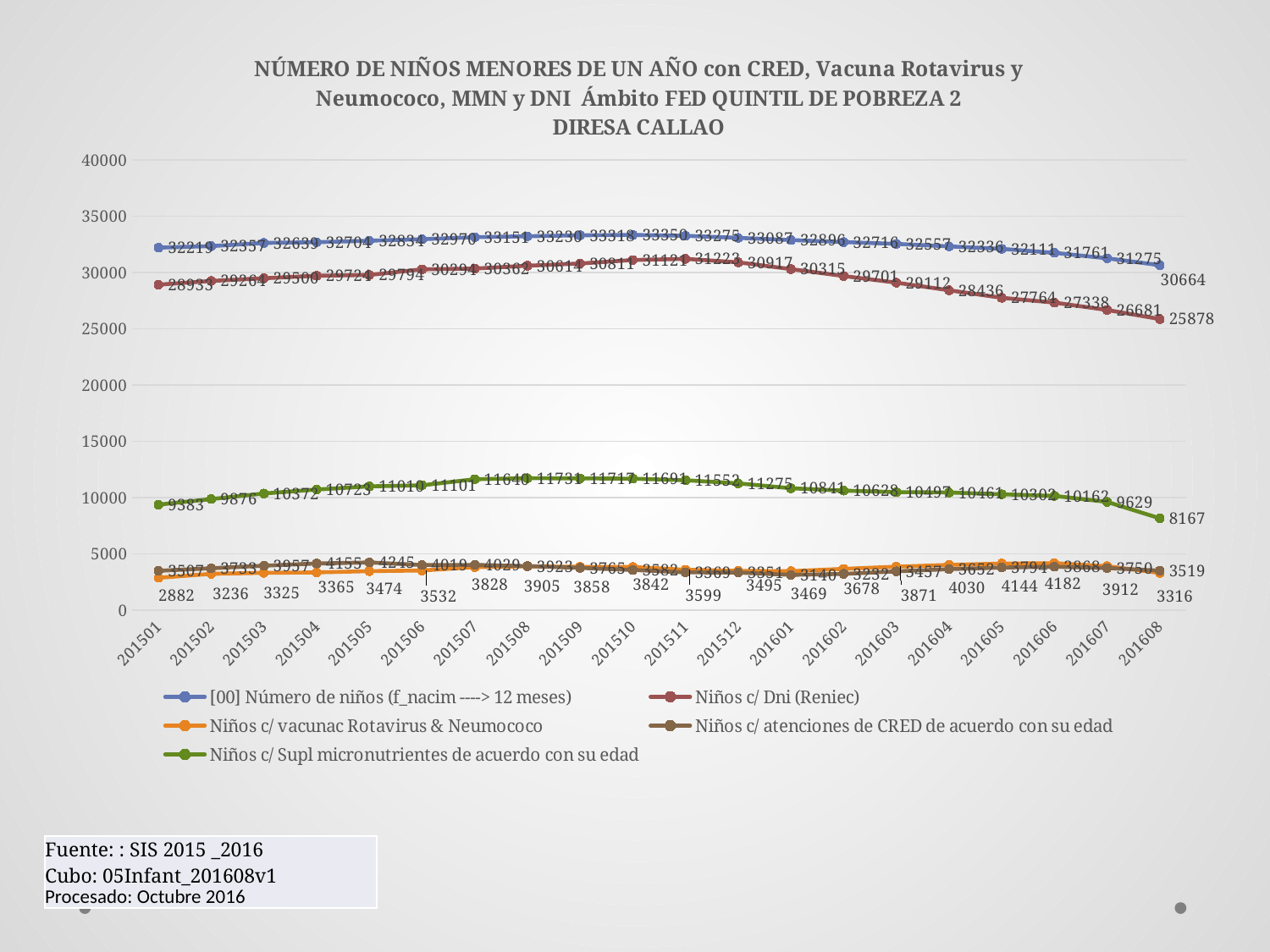
In which month does 'Niños c/ Supl micronutrientes de acuerdo con su edad' reach its highest value? 201508 What is the value of 'Niños c/ vacunac Rotavirus & Neumococo' at 201501? 2882 What is the value of 'Niños c/ Supl micronutrientes de acuerdo con su edad' at 201608? 8167 Is the value of '[00] Número de niños' at 201501 greater or less than 30000? greater How many months are shown on the x axis? 20 At 201608, which is larger: 'Niños c/ vacunac Rotavirus & Neumococo' or 'Niños c/ atenciones de CRED de acuerdo con su edad'? Niños c/ atenciones de CRED de acuerdo con su edad What is the value of the series '[00] Número de niños (f_nacim ----> 12 meses)' at 201608? 30664 What is the difference between '[00] Número de niños' and 'Niños c/ Dni (Reniec)' at 201608? 4786 In which month is 'Niños c/ Supl micronutrientes de acuerdo con su edad' at its lowest? 201608 What kind of chart is shown on the slide? line chart What is the value of 'Niños c/ Dni (Reniec)' at 201608? 25878 How many series does the legend list? 5